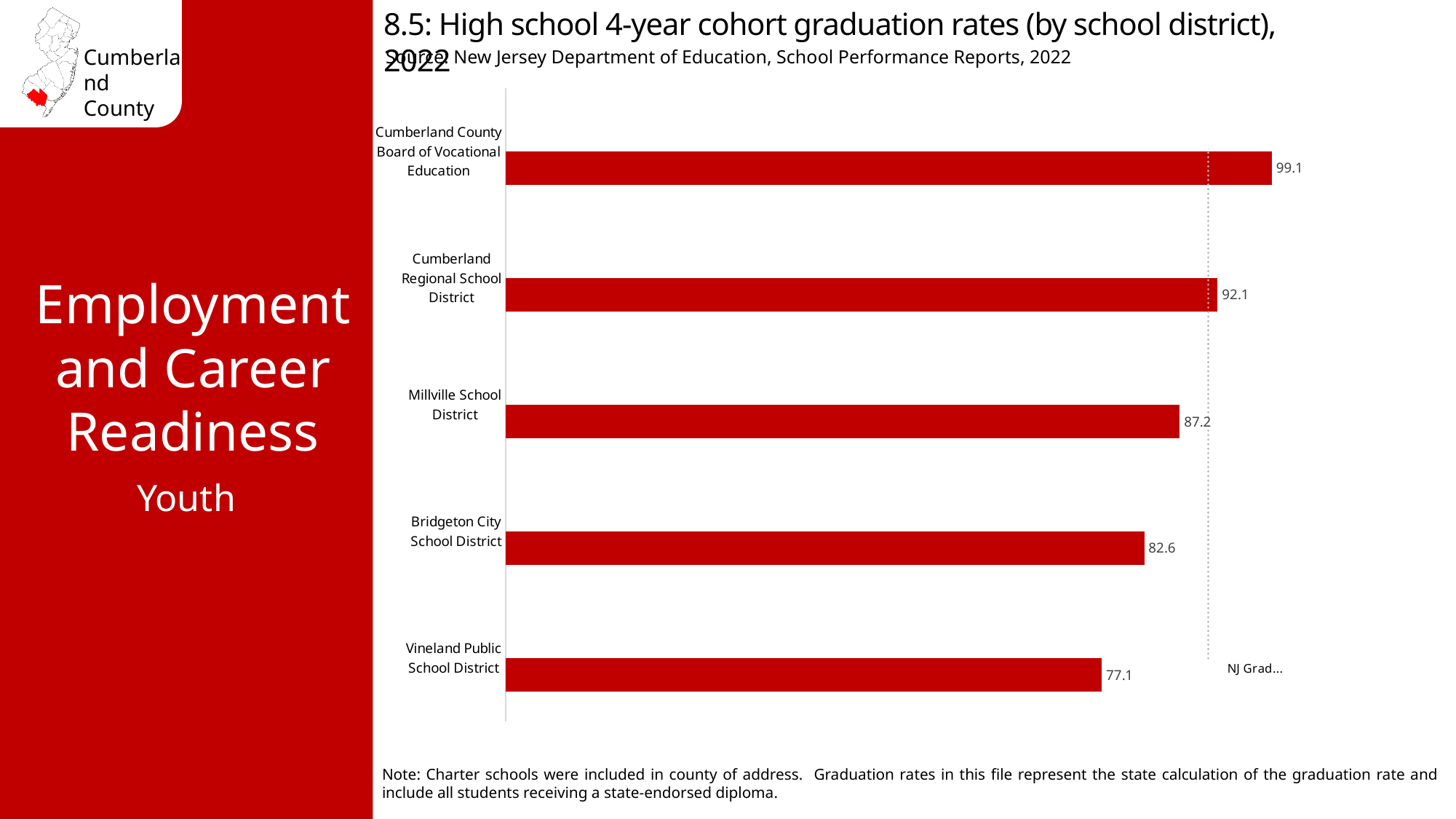
What is the 4-year cohort graduation rate for Cumberland County Board of Vocational Education? 99.1 Which school district has the lowest graduation rate on the chart? Vineland Public School District What is the graduation rate shown for Vineland Public School District? 77.1 What is the difference between the highest and lowest graduation rates on the chart? 22.0 What is the source cited for the graduation rate data? New Jersey Department of Education, School Performance Reports, 2022 What is the difference between the graduation rates of Cumberland Regional School District and Bridgeton City School District? 9.5 Which has a higher graduation rate, Millville School District or Bridgeton City School District? Millville School District How many school districts are shown on the chart? 5 What type of chart is used to show the graduation rates? Bar chart Which school district has the highest graduation rate on the chart? Cumberland County Board of Vocational Education What is the graduation rate shown for Bridgeton City School District? 82.6 What is the graduation rate shown for Millville School District? 87.2